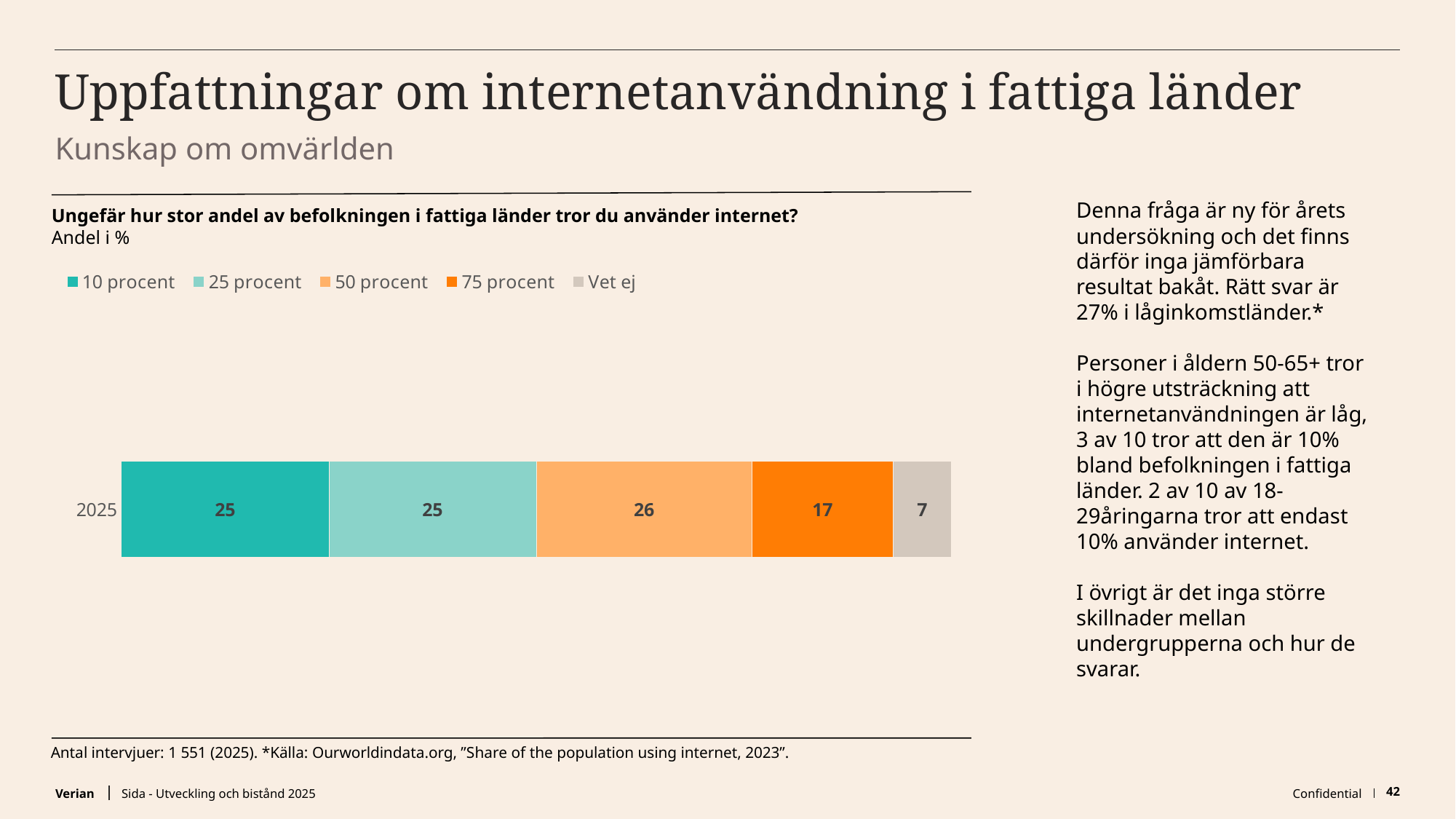
How many categories (bars) are plotted in the chart? 1 Which series has the smallest value in the 2025 bar? Vet ej What kind of chart is shown on the slide? Stacked bar chart How many series does the legend list? 5 What is the difference between the "75 procent" value and the "Vet ej" value in the 2025 bar? 10 What value is shown for the "50 procent" segment of the 2025 bar? 26 What value is shown for the "Vet ej" segment of the 2025 bar? 7 Which is larger in the 2025 bar: the "50 procent" value or the "75 procent" value? 50 procent What is the total of all segments in the 2025 stacked bar? 100 Which series has the largest value in the 2025 bar? 50 procent What value is shown for the "75 procent" segment of the 2025 bar? 17 What value is shown for the "10 procent" segment of the 2025 bar? 25